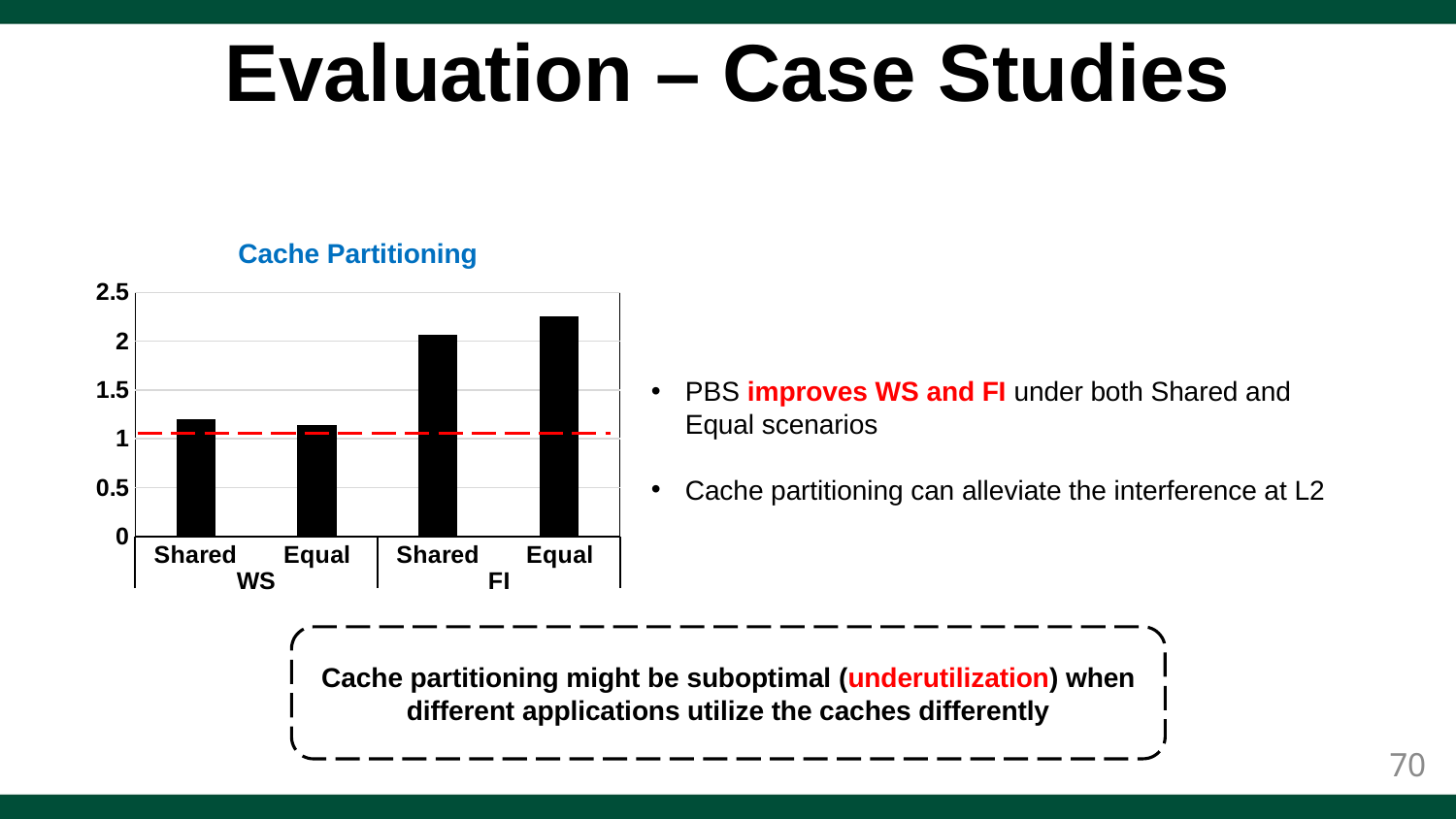
Is the value for WS Equal greater or less than 1? greater What kind of chart is shown under the title "Cache Partitioning"? bar chart Which bar is the highest in the Cache Partitioning chart? FI Equal Is the value for FI Equal greater or less than 2? greater Which bar is the lowest in the Cache Partitioning chart? WS Equal Which is larger, the FI Shared bar or the WS Shared bar? FI Shared What is the highest value shown on the y axis of the Cache Partitioning chart? 2.5 Is the value for WS Shared greater or less than 1.5? less What is the title of the chart on the slide? Cache Partitioning How many bars are plotted in the Cache Partitioning chart? 4 Which is larger, the FI Equal bar or the FI Shared bar? FI Equal